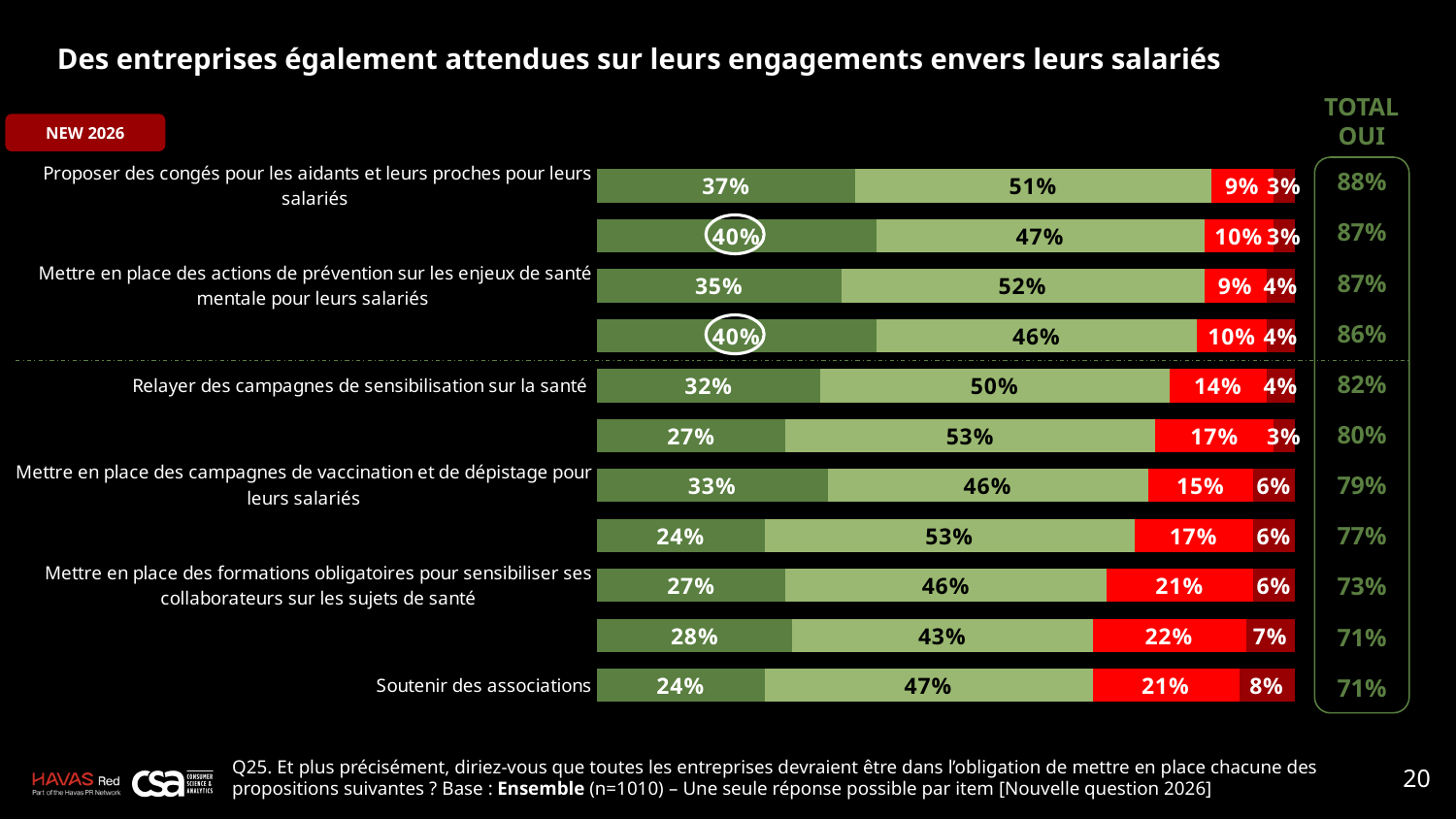
What is the TOTAL OUI value for "Relayer des campagnes de sensibilisation sur la santé"? 82% What is the title of the slide? Des entreprises également attendues sur leurs engagements envers leurs salariés How many bars are plotted in the chart? 11 What is the difference between the dark green (first) segment for "Proposer des congés pour les aidants et leurs proches pour leurs salariés" (37%) and for "Soutenir des associations" (24%)? 13 percentage points What kind of chart is shown on the slide? Stacked bar chart What is the value of the light green (second) segment for "Soutenir des associations"? 47% What is the value of the dark red (last) segment for "Soutenir des associations"? 8% What is the value of the red (third) segment for "Mettre en place des campagnes de vaccination et de dépistage pour leurs salariés"? 15% Which item has the highest TOTAL OUI value? Proposer des congés pour les aidants et leurs proches pour leurs salariés What is the TOTAL OUI value for "Soutenir des associations"? 71% Which has the larger light green (second) segment: "Mettre en place des actions de prévention sur les enjeux de santé mentale pour leurs salariés" or "Soutenir des associations"? Mettre en place des actions de prévention sur les enjeux de santé mentale pour leurs salariés What is the value of the dark green (first) segment for "Proposer des congés pour les aidants et leurs proches pour leurs salariés"? 37%